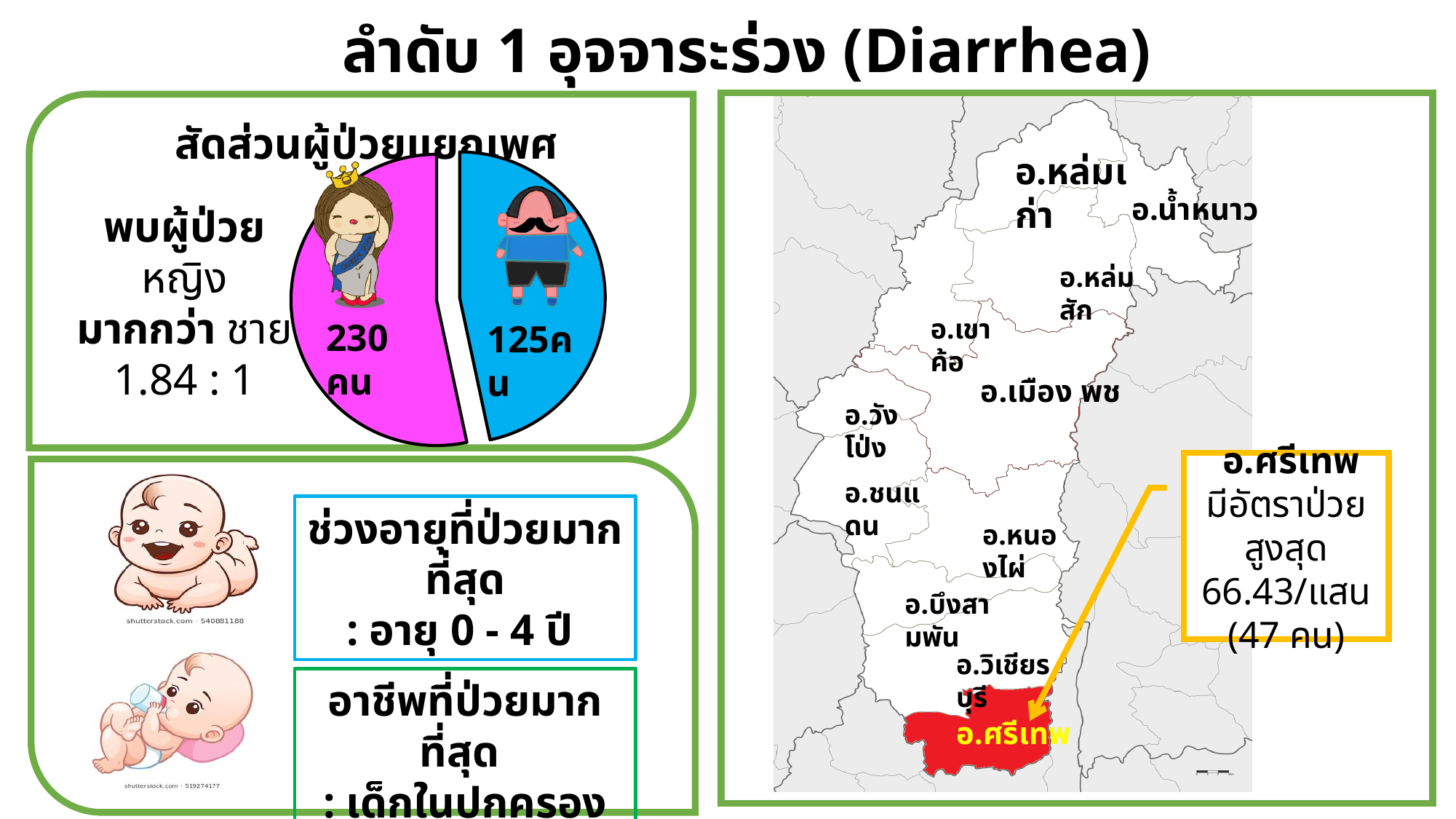
What is the title of the pie chart on the slide? สัดส่วนผู้ป่วยแยกเพศ In the pie chart, how many patients are female (หญิง)? 230 คน What kind of chart is shown in the top-left panel of the slide? pie chart Which slice of the pie chart is larger, female or male? female How many more female patients than male patients are shown in the pie chart? 105 Is the female value in the pie chart greater or less than the male value? greater What colour is the female slice of the pie chart? pink (magenta) Which slice of the pie chart is smaller, female or male? male In the pie chart, how many patients are male (ชาย)? 125 คน What share of the pie chart do female patients represent? 64.8% How many slices does the pie chart have? 2 What is the total number of patients represented in the pie chart? 355